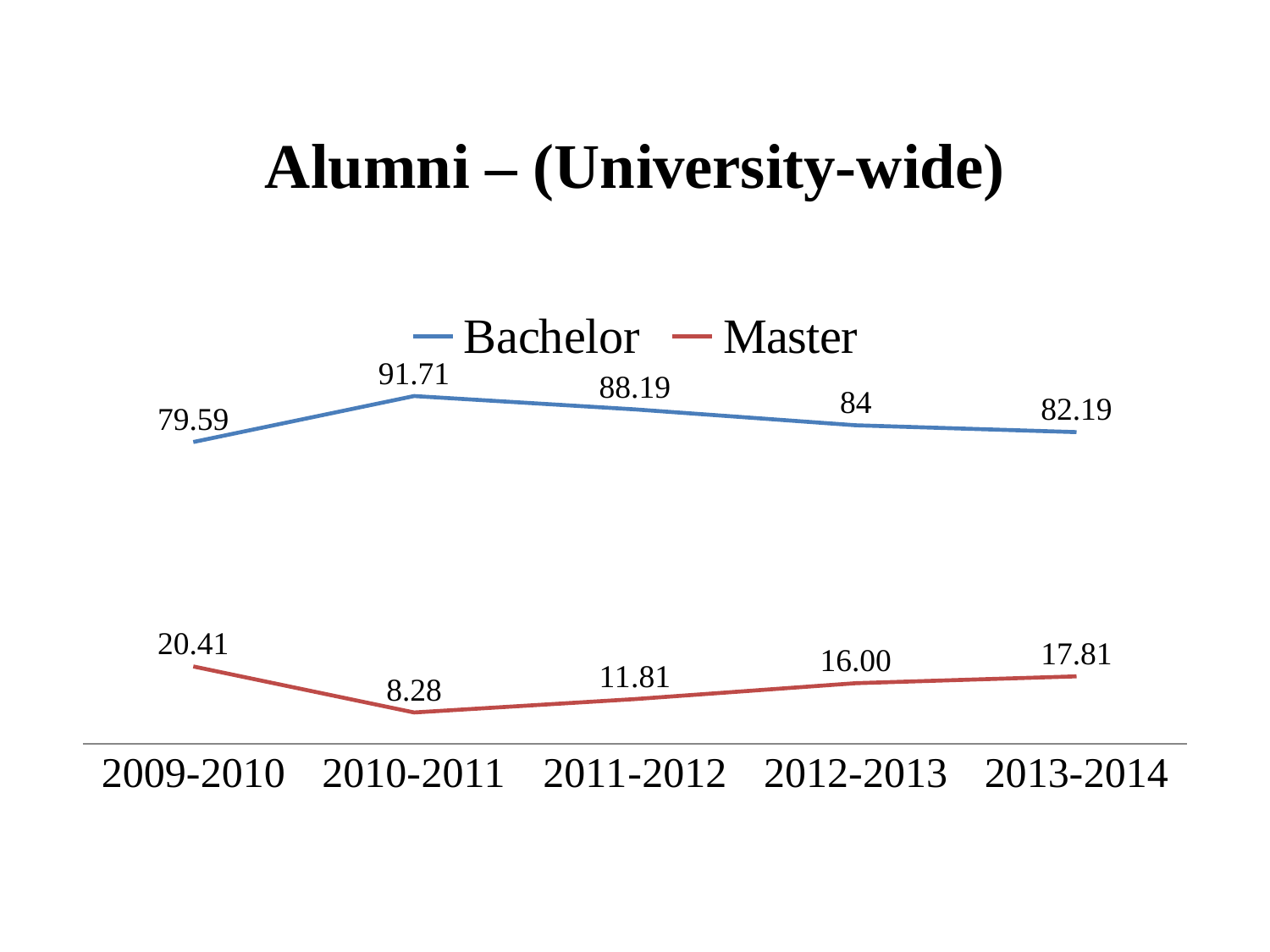
How many years are shown on the x axis? 5 What is the difference between the Bachelor and Master values in 2009-2010? 59.18 What kind of chart is shown? line chart Does the Bachelor line rise or fall from 2010-2011 to 2013-2014? fall What is the Master value for 2012-2013? 16.00 What is the title of the chart? Alumni – (University-wide) In which year is the Master value lowest? 2010-2011 How many series does the legend list? 2 What is the Bachelor value for 2010-2011? 91.71 In which year is the Bachelor value highest? 2010-2011 Which is larger, the Master value for 2009-2010 or for 2013-2014? 2009-2010 What is the Bachelor value for 2013-2014? 82.19